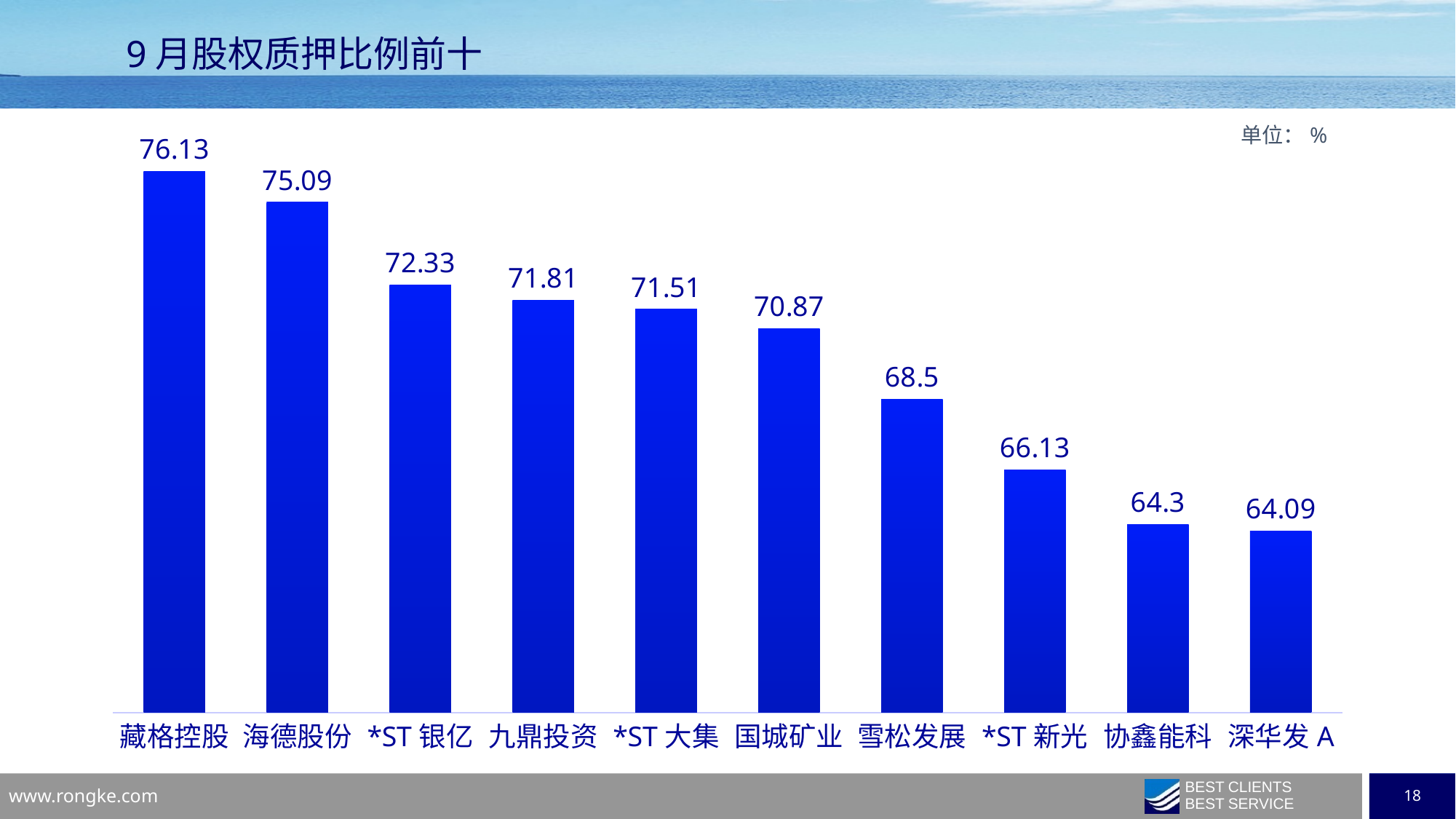
Which category has the lowest value? 深华发 A Do the values rise or fall from left to right along the x axis? Fall How many categories are shown in the chart? 10 What is the difference between the values for 雪松发展 and *ST 新光? 2.37 What is the value for 国城矿业? 70.87 Which is larger, the value for 九鼎投资 or the value for *ST 大集? 九鼎投资 What is the value for 协鑫能科? 64.3 Which category has the highest value? 藏格控股 What is the title of the chart? 9 月股权质押比例前十 What is the difference between the values for 藏格控股 and 海德股份? 1.04 What is the value for 藏格控股? 76.13 What kind of chart is shown on the slide? Bar chart